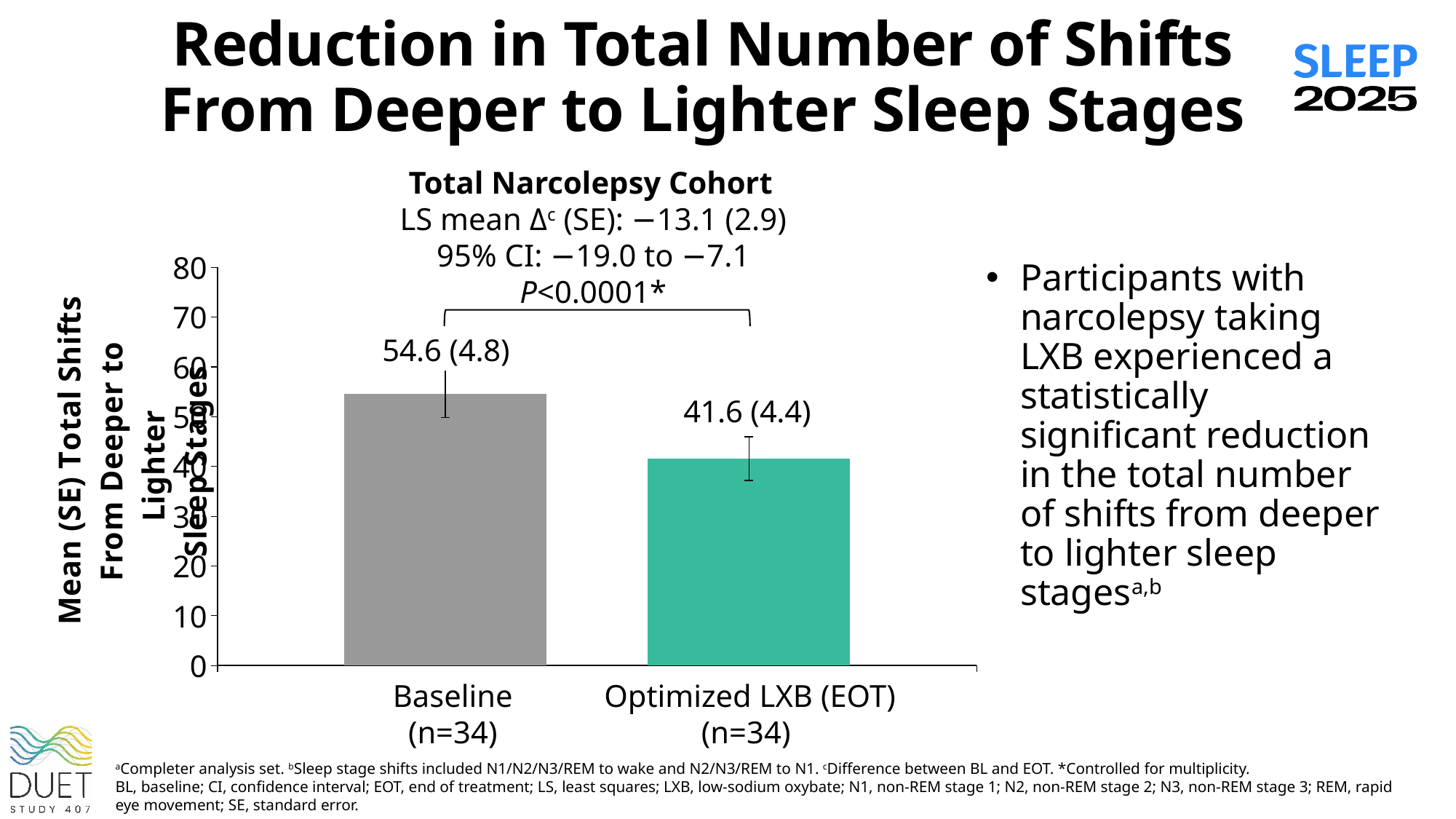
Which bar is higher, Baseline or Optimized LXB (EOT)? Baseline What is the mean (SE) total shifts from deeper to lighter sleep stages at Optimized LXB (EOT)? 41.6 (4.4) How many bars are shown in the chart? 2 What is the LS mean change (SE) shown above the chart? −13.1 (2.9) Do the values rise or fall from Baseline to Optimized LXB (EOT)? Fall Which category has the lowest mean total shifts? Optimized LXB (EOT) What is the sample size (n) for the Baseline group? 34 What is the mean (SE) total shifts from deeper to lighter sleep stages at Baseline? 54.6 (4.8) What kind of chart is shown on the slide? Bar chart Is the value for Optimized LXB (EOT) greater or less than 50? less What is the difference between the Baseline mean (54.6) and the Optimized LXB (EOT) mean (41.6)? 13.0 Is the value for Baseline greater or less than 50? greater